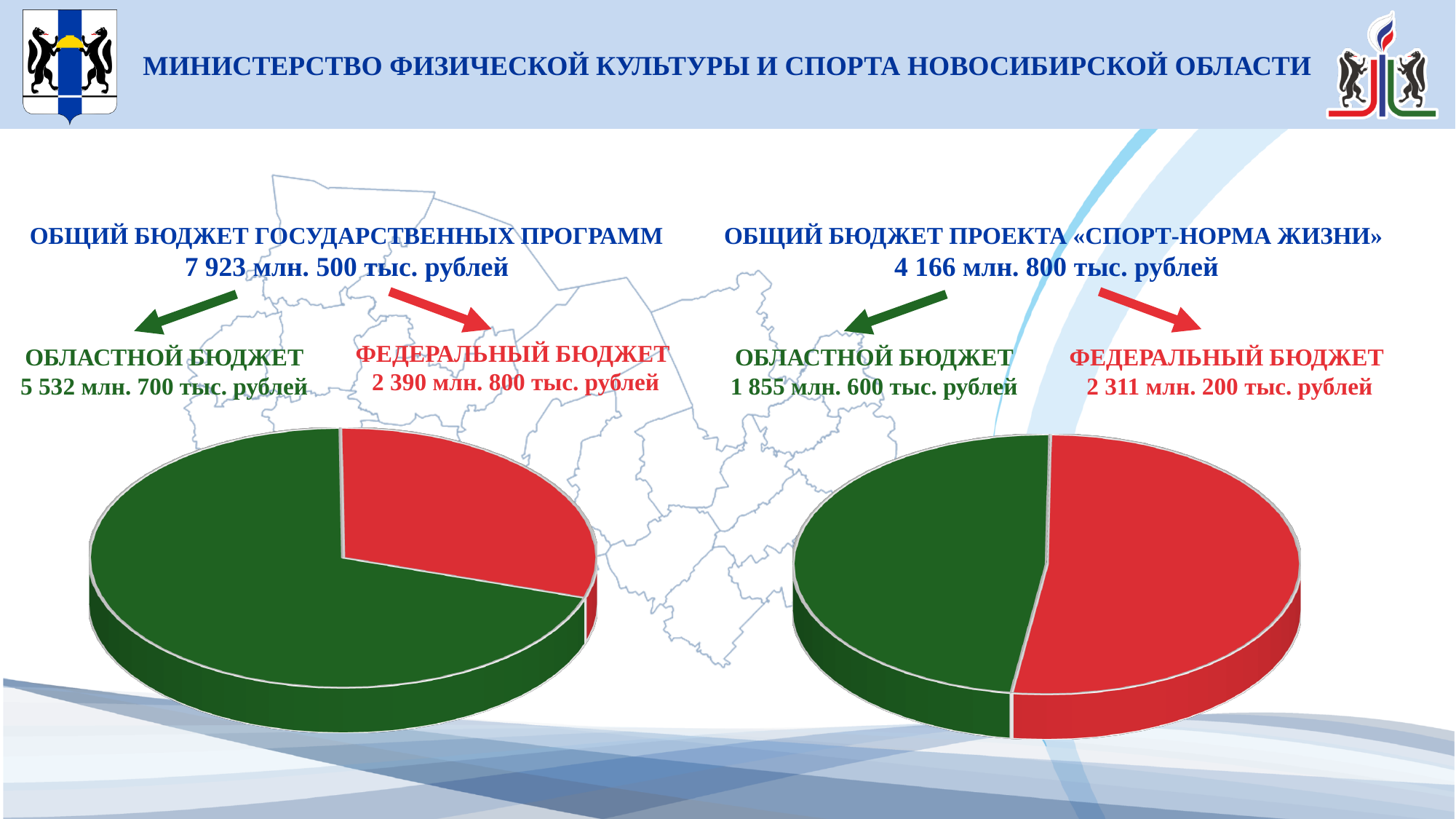
In the left pie chart (state programmes budget), what is the value for the regional budget (ОБЛАСТНОЙ БЮДЖЕТ)? 5 532 млн. 700 тыс. рублей In the right pie chart, which slice is larger: the regional budget or the federal budget? federal budget (ФЕДЕРАЛЬНЫЙ БЮДЖЕТ) In the right pie chart («Спорт-норма жизни» project), what is the value for the regional budget? 1 855 млн. 600 тыс. рублей In the left pie chart (state programmes budget), what is the value for the federal budget (ФЕДЕРАЛЬНЫЙ БЮДЖЕТ)? 2 390 млн. 800 тыс. рублей What type of chart is used on the left side of the slide? pie chart In the right pie chart («Спорт-норма жизни» project), what is the value for the federal budget? 2 311 млн. 200 тыс. рублей What is the total budget shown above the left pie chart (state programmes)? 7 923 млн. 500 тыс. рублей In the left pie chart, which slice is larger: the regional budget or the federal budget? regional budget (ОБЛАСТНОЙ БЮДЖЕТ) In the right pie chart, by how much does the federal budget exceed the regional budget? 455 млн. 600 тыс. рублей In the left pie chart, by how much does the regional budget exceed the federal budget? 3 141 млн. 900 тыс. рублей How many slices does each pie chart on the slide have? 2 What is the total budget shown above the right pie chart («Спорт-норма жизни» project)? 4 166 млн. 800 тыс. рублей